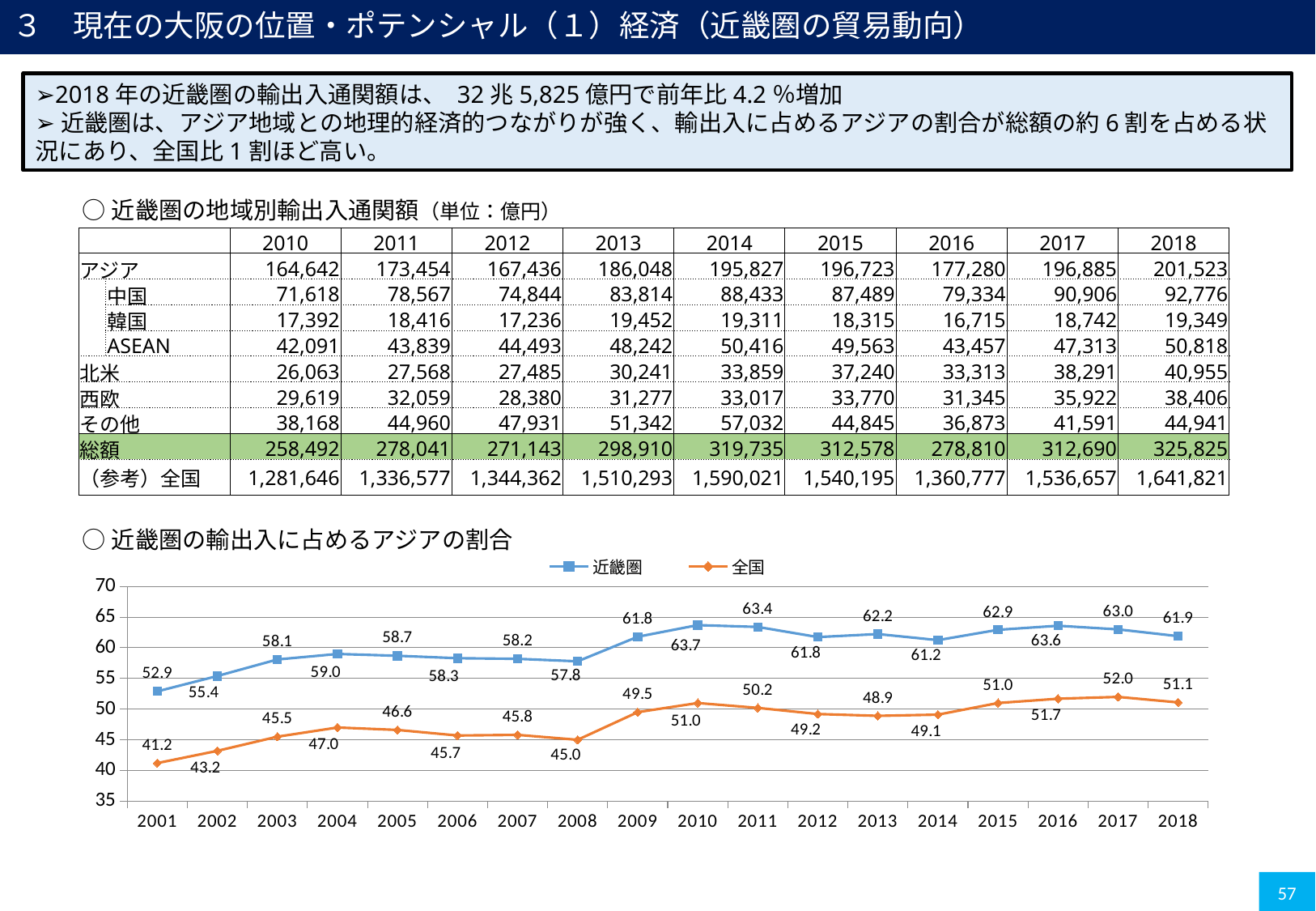
In the line chart, what is the value for 全国 in 2001? 41.2 In the line chart, which year has the lowest value for 全国? 2001 In the line chart, is the value for 全国 in 2004 greater or less than 50? less What type of chart is shown under the heading 近畿圏の輸出入に占めるアジアの割合? line chart In the line chart, what is the difference between 近畿圏 and 全国 in 2018? 10.8 In the line chart, what is the value for 近畿圏 in 2018? 61.9 In the line chart, which series is drawn in orange? 全国 How many series does the legend of the line chart list? 2 In the line chart, what is the value for 近畿圏 in 2010? 63.7 In the line chart, which series has the higher value in 2009, 近畿圏 or 全国? 近畿圏 In the line chart, which year has the lowest value for 近畿圏? 2001 How many years are plotted along the x axis of the line chart? 18